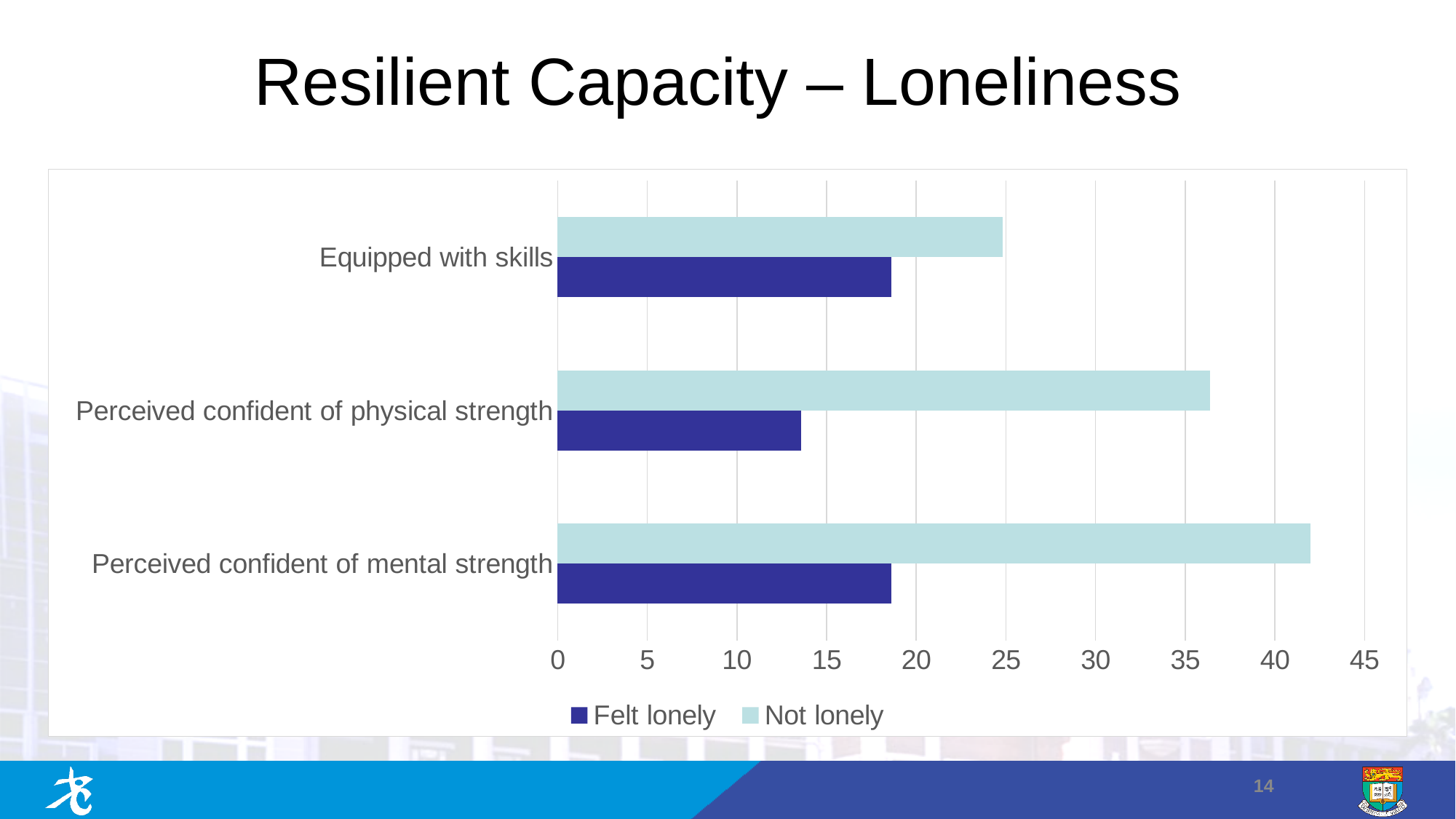
Is the Felt lonely value for Perceived confident of physical strength greater or less than 15? less What type of chart is shown on the slide? bar chart Which category has the lowest value for Not lonely? Equipped with skills How many series does the legend list? 2 For Perceived confident of physical strength, which series has the larger value, Felt lonely or Not lonely? Not lonely Which category has the lowest value for Felt lonely? Perceived confident of physical strength Which category has the highest value for Not lonely? Perceived confident of mental strength Is the Not lonely value for Perceived confident of physical strength greater or less than 35? greater Is the Not lonely value for Perceived confident of mental strength greater or less than 40? greater What is the title of the slide? Resilient Capacity – Loneliness How many categories are shown on the chart? 3